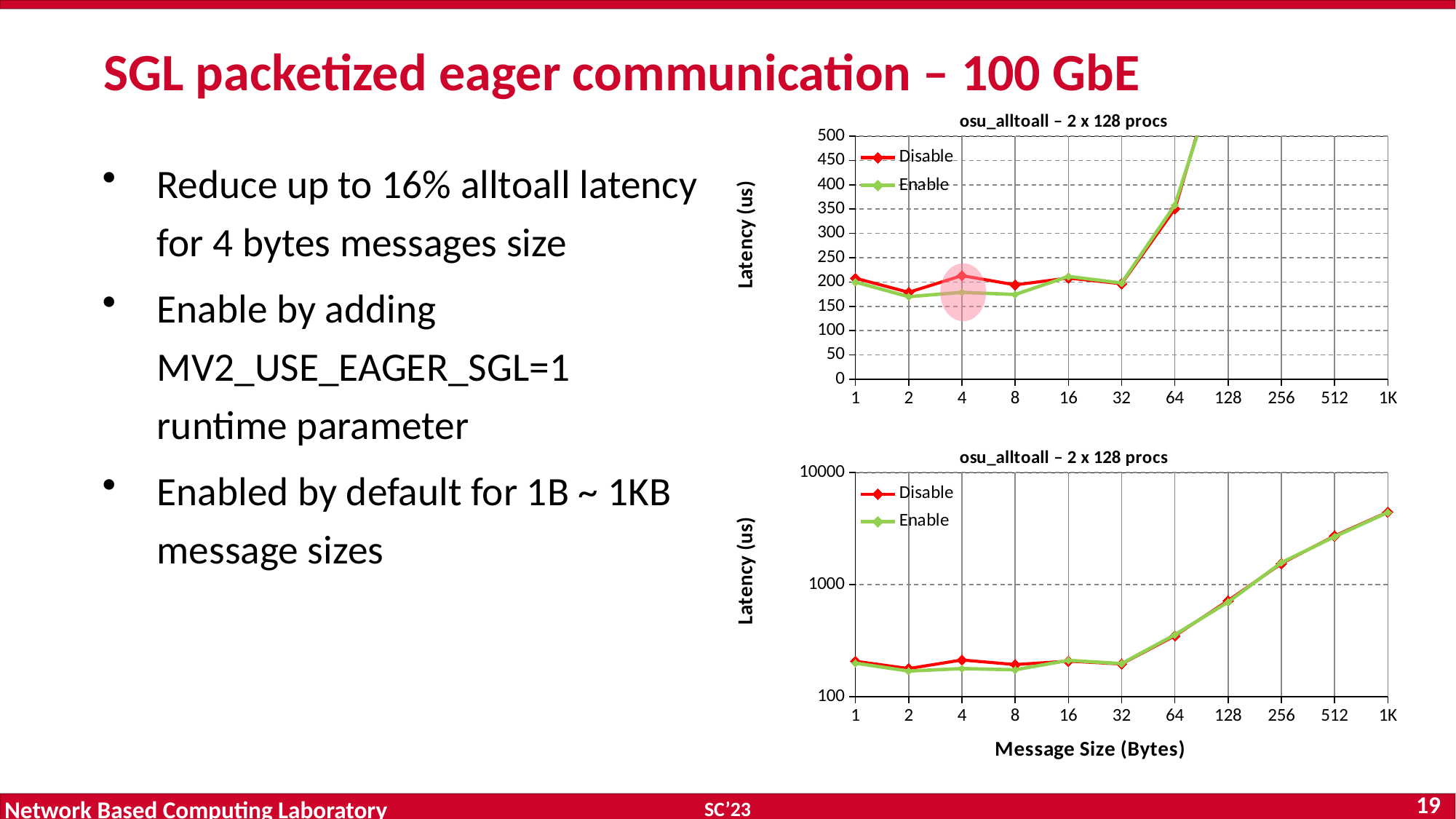
In the bottom chart, is the Enable latency at message size 64 greater or less than 1000? less In the bottom chart, is the Disable latency at message size 1K greater or less than 1000? greater In the bottom chart, at which message size is the Disable latency highest? 1K What are the two legend entries in the top chart? Disable and Enable What kind of chart is the top chart on the slide? line chart In the bottom chart, do the latency values rise or fall as message size increases from 64 to 1K? rise In the top chart, is the Disable latency at message size 4 greater or less than 200? greater How many series does the legend of the bottom chart list? 2 In the top chart, at message size 4, which series has the higher latency, Disable or Enable? Disable How many message sizes are shown on the x axis of the bottom chart? 11